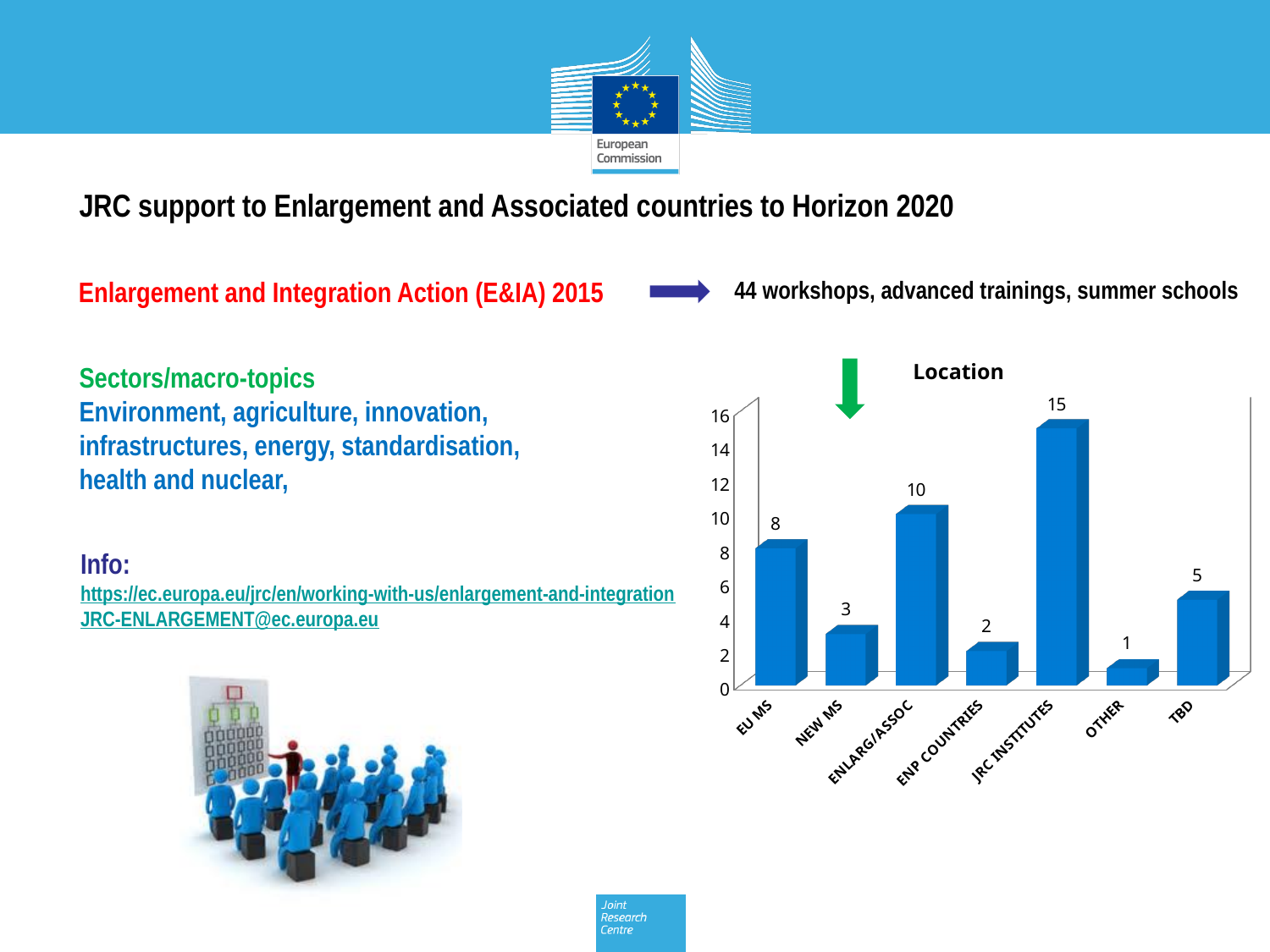
Which category has the highest value in the Location chart? JRC INSTITUTES What is the difference between the values for JRC INSTITUTES and ENLARG/ASSOC in the Location chart? 5 What is the value for TBD in the Location chart? 5 Which is larger in the Location chart, the value for NEW MS or the value for TBD? TBD Is the value for ENLARG/ASSOC in the Location chart greater or less than 6? greater How many categories are shown in the Location chart? 7 Which category has the lowest value in the Location chart? OTHER What is the value for ENP COUNTRIES in the Location chart? 2 What is the value for EU MS in the Location chart? 8 What kind of chart is the Location chart? bar chart What is the title of the chart on the slide? Location What is the value for JRC INSTITUTES in the Location chart? 15